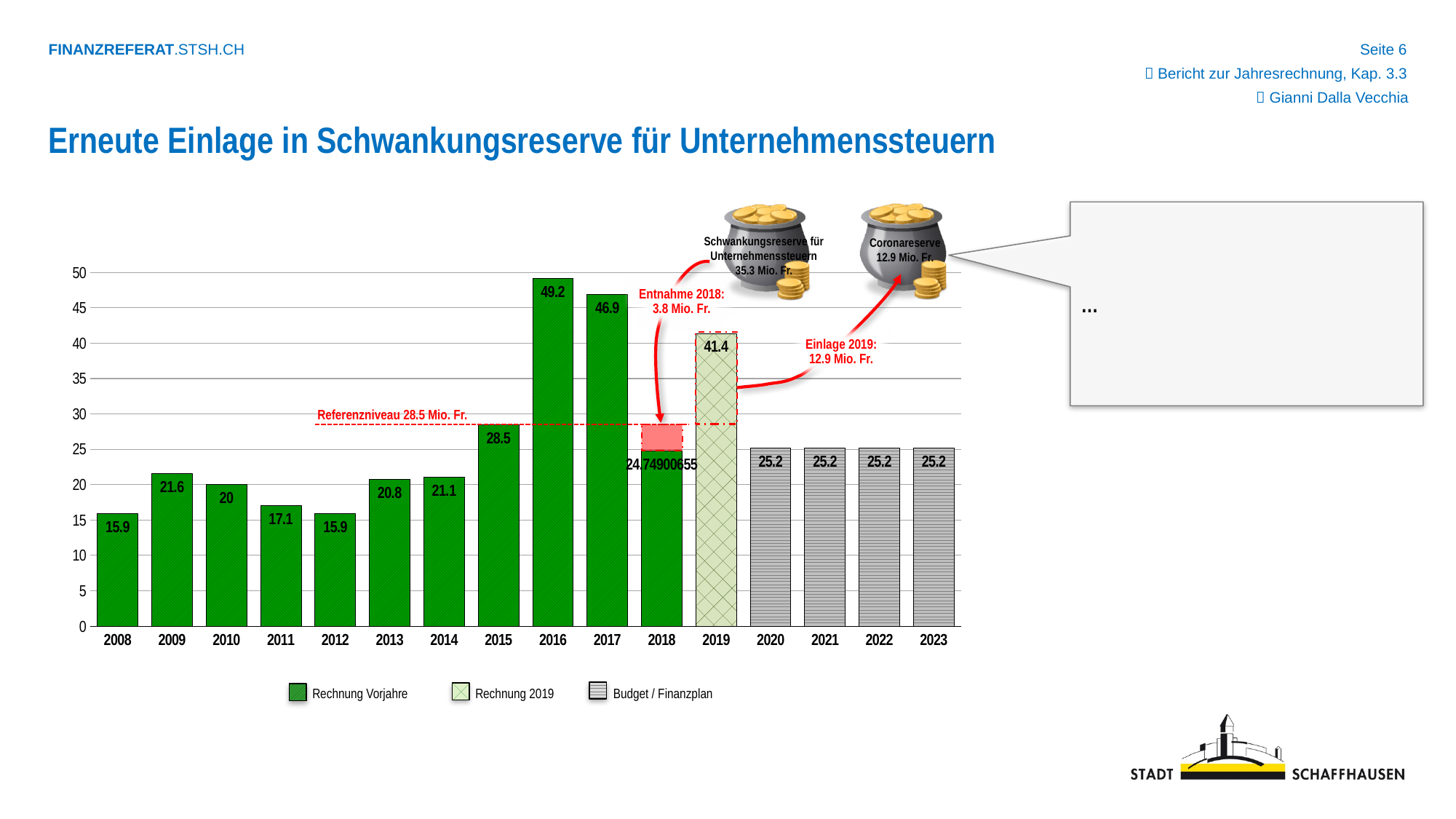
What is the value shown for 2011? 17.1 What is the value shown for 2016? 49.2 What is the legend label for the bar for 2019? Rechnung 2019 Is the value for 2018 greater or less than 30? less Which year has the highest bar in the chart? 2016 Which is larger, the value for 2015 or the value for 2014? 2015 What kind of chart is shown on the slide? bar chart What is the difference between the values for 2016 and 2017? 2.3 How many years are shown on the x axis of the chart? 16 How many series does the legend list? 3 What is the value shown for 2019? 41.4 What value is shown for each of the years 2020 through 2023? 25.2